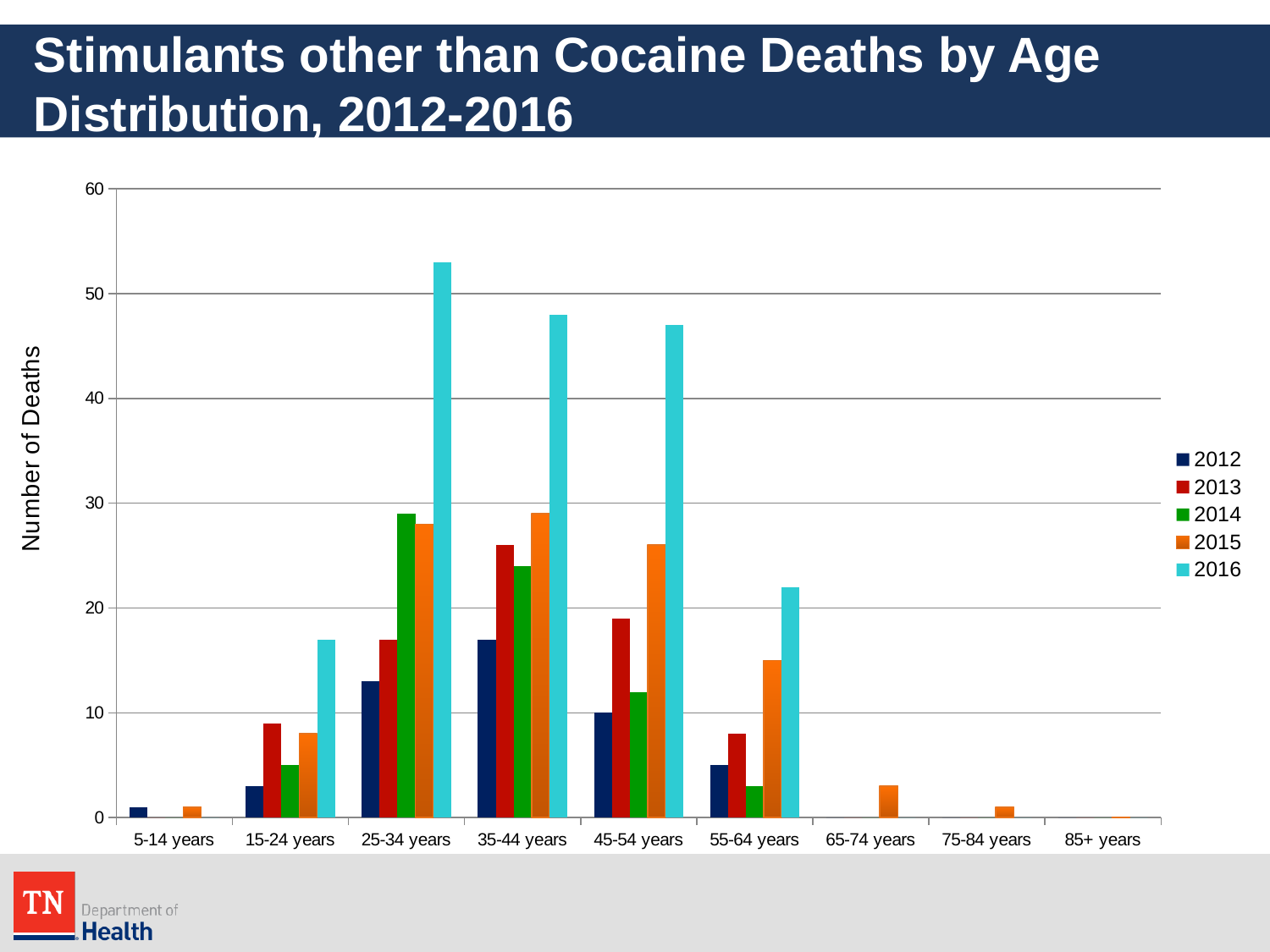
Which age group has the highest 2016 bar? 25-34 years What kind of chart is shown on the slide? bar chart How many age groups are shown on the x axis? 9 Is the 2016 value for 45-54 years greater or less than 50? less What is the title of the y axis? Number of Deaths Which year has the highest bar in the 45-54 years group? 2016 Is the 2015 value for 25-34 years greater or less than 20? greater Which year has the lowest bar in the 15-24 years group? 2012 In the 45-54 years group, which is larger, the 2015 bar or the 2014 bar? 2015 How many series does the legend list? 5 Is the 2016 value for 25-34 years greater or less than 50? greater